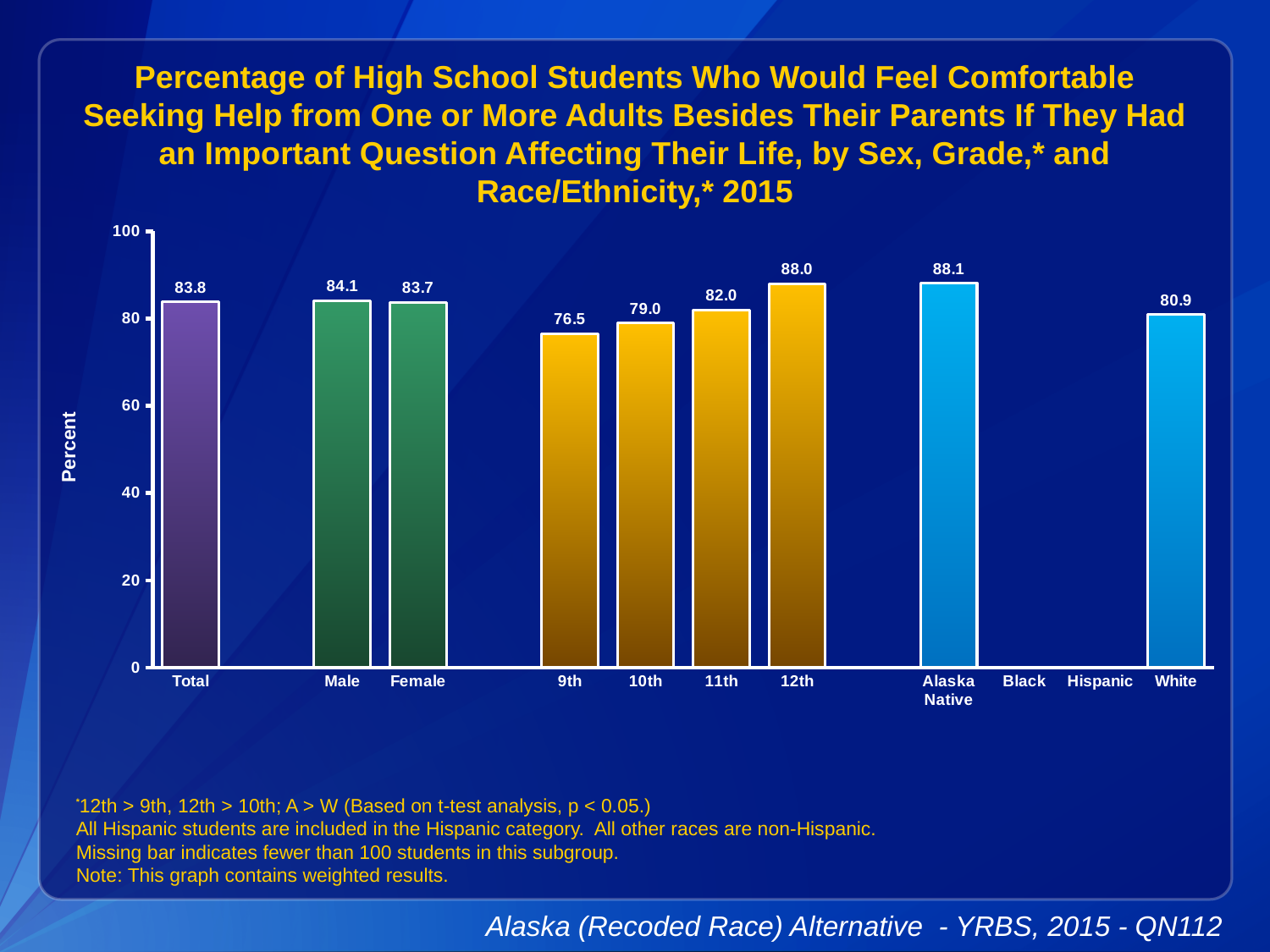
What is the value for Total? 83.8 Do the values rise or fall from 9th grade to 12th grade? rise Is the value for 9th grade greater or less than 80? less What percentage is shown for 9th grade students? 76.5 What is the difference between the values for 12th grade and 9th grade? 11.5 What is the value for Alaska Native students? 88.1 What is the difference between the Male and Female values? 0.4 How many bars are plotted on the chart? 9 What kind of chart is shown on the slide? bar chart Which is larger, the value for 11th grade or the value for 10th grade? 11th Which category has the lowest value? 9th What is the value for White students? 80.9